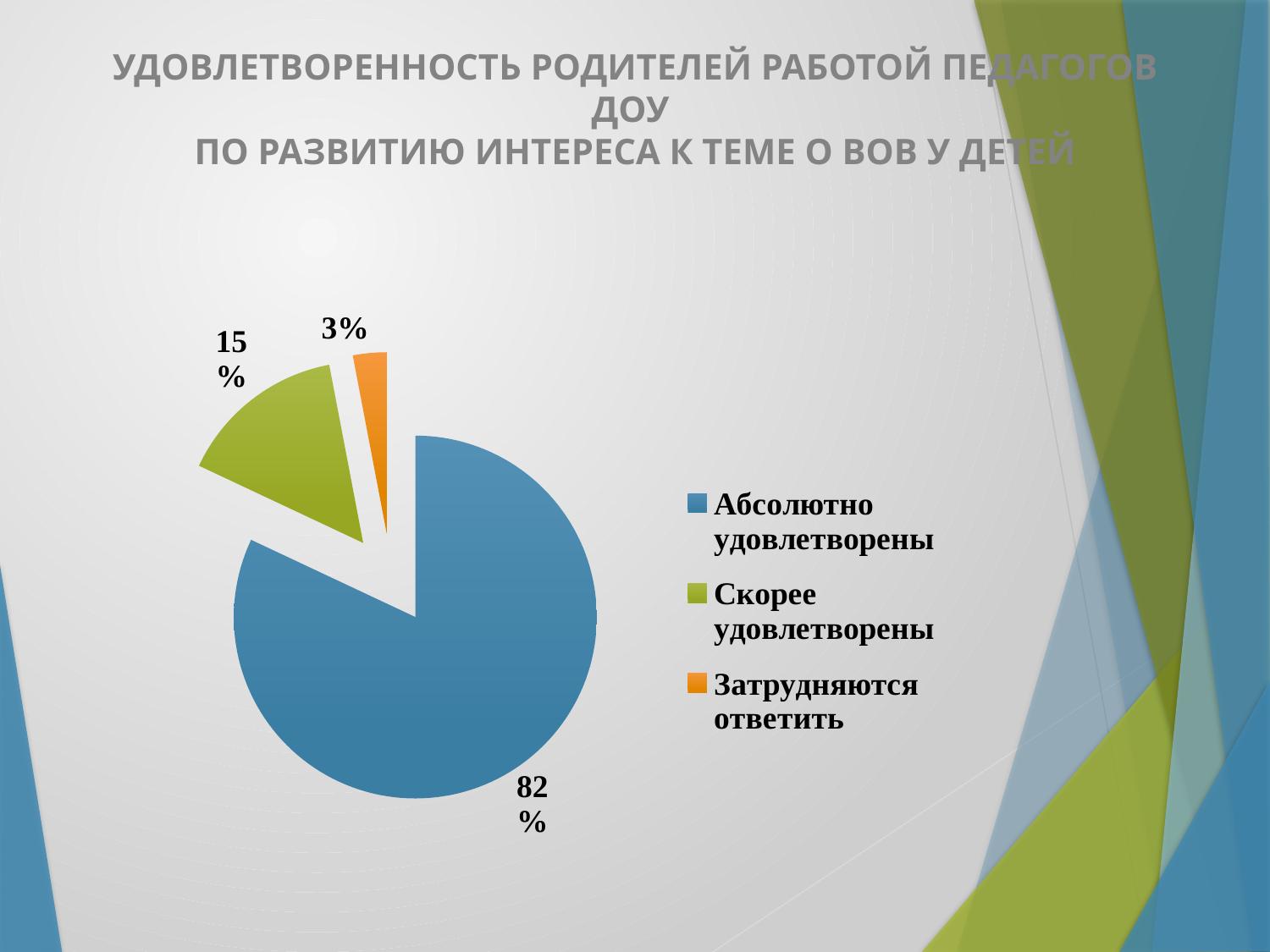
What is the difference in percentage points between "Скорее удовлетворены" and "Затрудняются ответить"? 12 How many entries does the legend list? 3 Which category has the smallest slice of the pie? Затрудняются ответить What share of the pie is labelled "Скорее удовлетворены"? 15% What is the difference in percentage points between "Абсолютно удовлетворены" and "Скорее удовлетворены"? 67 What share of the pie is labelled "Затрудняются ответить"? 3% What colour is the slice for "Затрудняются ответить"? orange Which category has the largest slice of the pie? Абсолютно удовлетворены Which is larger: the share for "Скорее удовлетворены" or for "Затрудняются ответить"? Скорее удовлетворены What kind of chart is shown on the slide? pie chart How many slices does the pie chart have? 3 What share of the pie is labelled "Абсолютно удовлетворены"? 82%